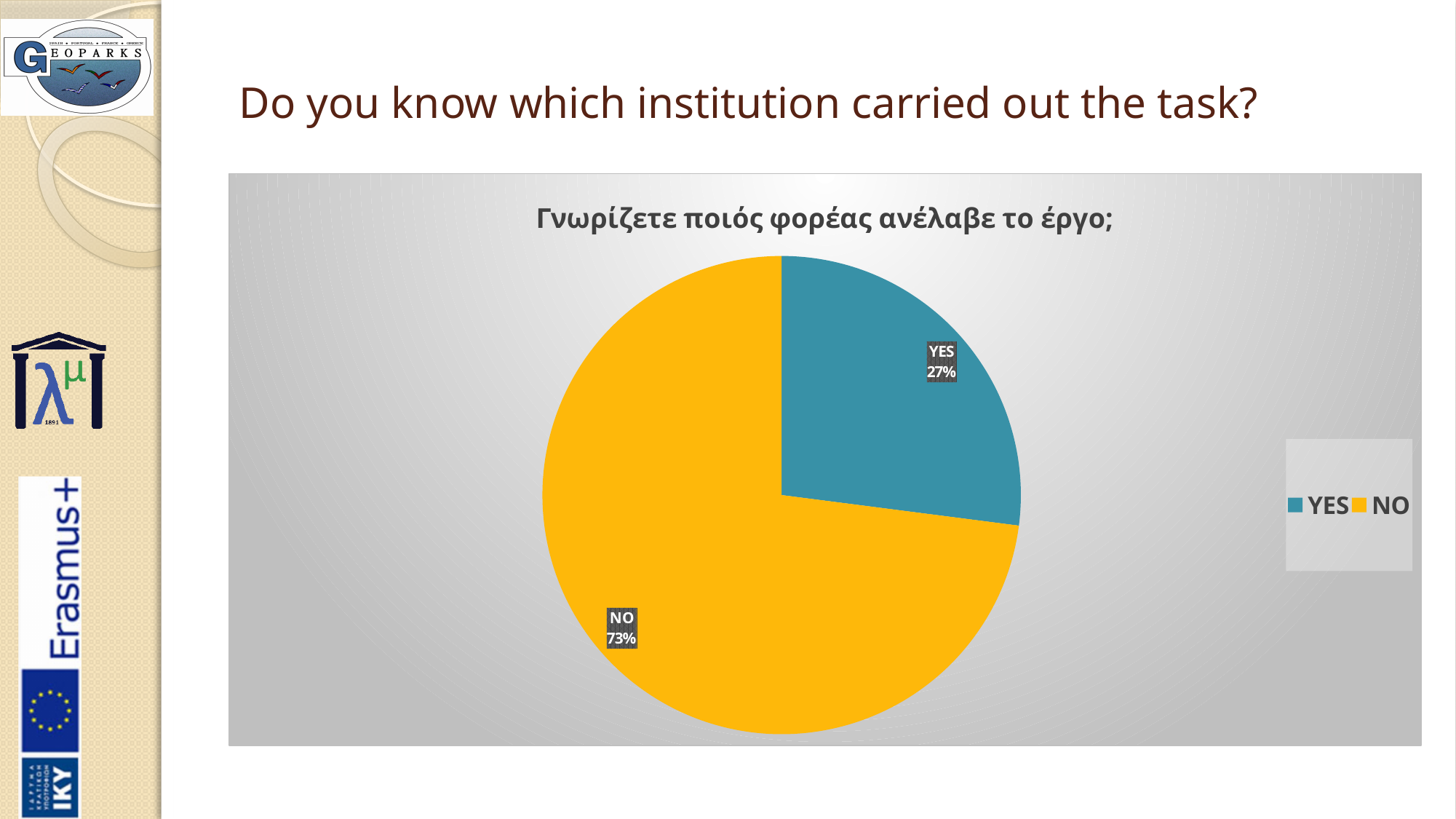
Which response has the smallest share of the pie? YES What is the title shown inside the chart area? Γνωρίζετε ποιός φορέας ανέλαβε το έργο; What share of the pie does the YES slice represent? 27% How many slices does the pie chart have? 2 What colour is the NO slice? yellow/orange What is the difference in percentage points between the NO and YES shares? 46 What type of chart is shown on the slide? pie chart Which response has the largest share of the pie? NO How many entries does the legend list? 2 Which share is larger, YES or NO? NO What percentage of respondents answered YES? 27% What percentage of respondents answered NO? 73%